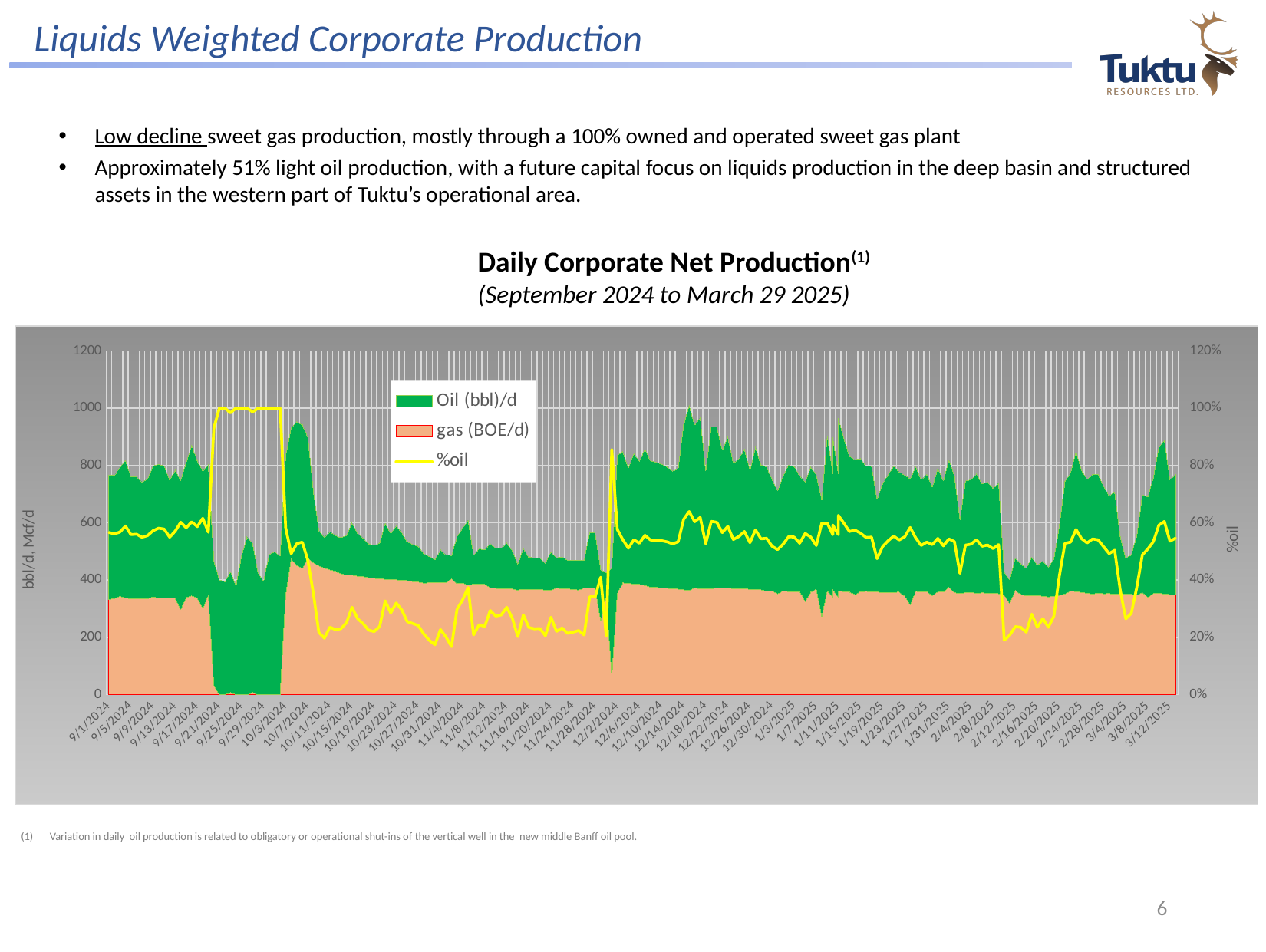
How many series does the chart legend list? 3 What kind of chart is shown on the slide? combination area and line chart What is the highest value shown on the left vertical axis? 1200 What are the three series listed in the chart legend? Oil (bbl)/d, gas (BOE/d), %oil Is the gas (BOE/d) value around 9/25/2024 greater or less than 200? less Is the %oil value around 9/25/2024 greater or less than 80%? greater Does the %oil line rise or fall between 10/7/2024 and 10/11/2024? fall Which series is plotted in green? Oil (bbl)/d What is the title of the chart? Daily Corporate Net Production What is the highest value shown on the right vertical axis? 120% Is the %oil value around 10/15/2024 greater or less than 40%? less